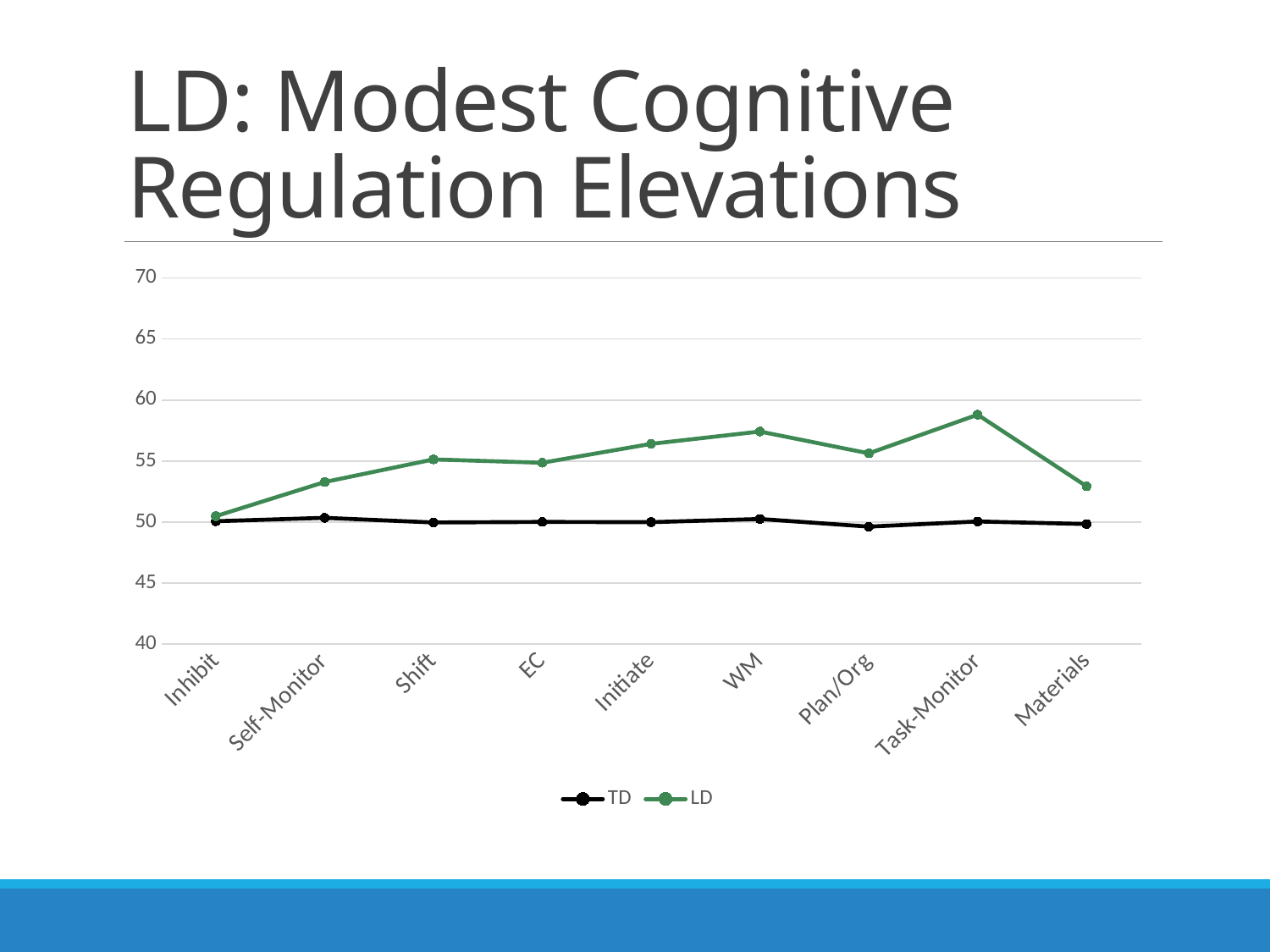
Is the LD value for Inhibit greater or less than 55? less At Task-Monitor, which series has the larger value, TD or LD? LD For the LD series, which category has the lowest value? Inhibit Does the LD line rise or fall from Task-Monitor to Materials? fall Is the LD value for Task-Monitor greater or less than 55? greater How many series does the legend list? 2 How many categories are plotted along the x axis? 9 Is the TD value for WM greater or less than 55? less For the LD series, which category has the highest value? Task-Monitor What colour is the LD line in the chart? green What kind of chart is shown on the slide? line chart